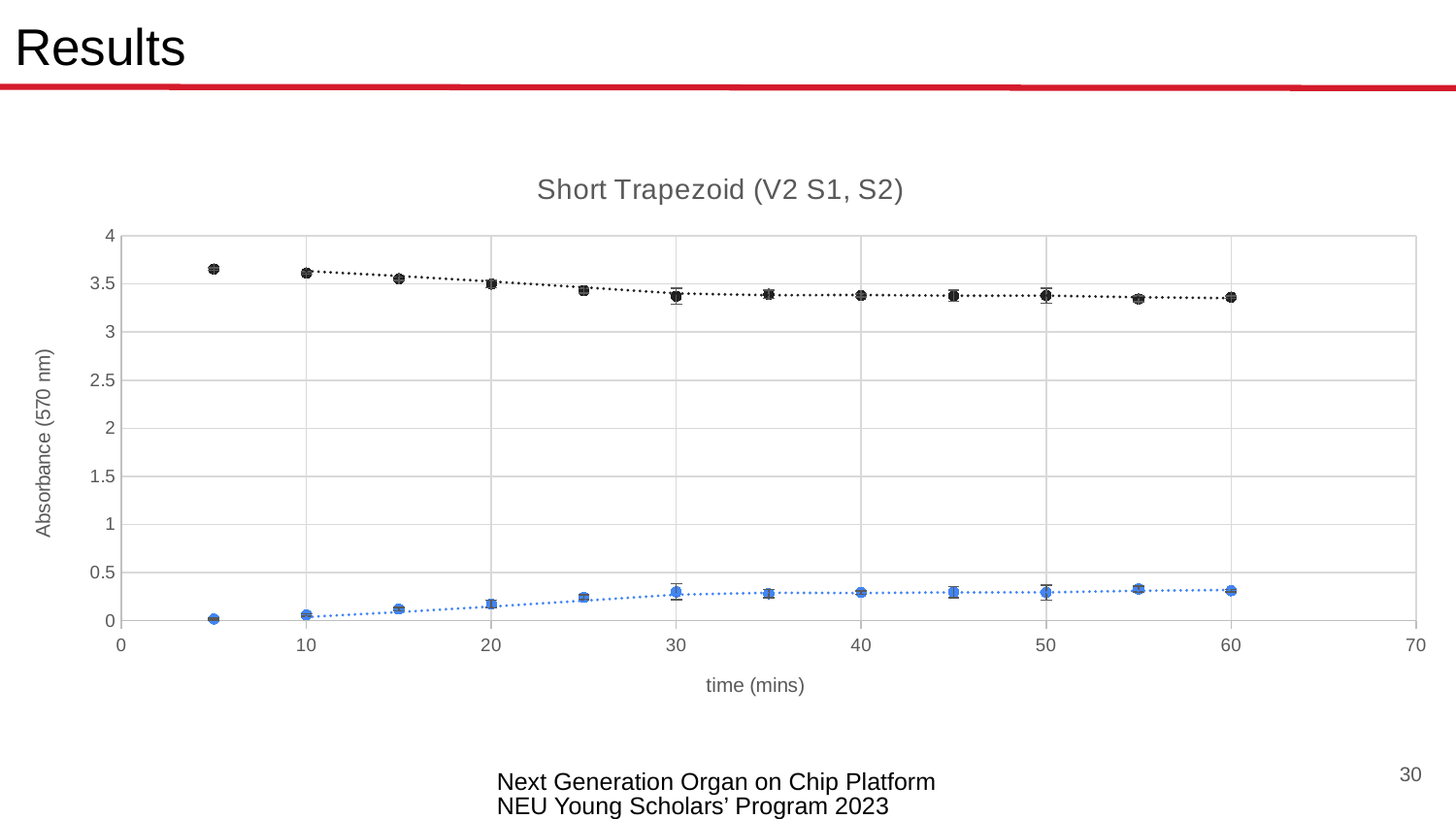
What kind of chart is shown on the slide? scatter chart What is the label of the y axis? Absorbance (570 nm) At 30 mins, which series has the larger absorbance, the black series or the blue series? the black series Is the value of the black series at 5 mins greater or less than 3.5? greater Is the value of the black series at 60 mins greater or less than 3.5? less How many data points does the black series have? 12 Is the value of the blue series at 5 mins greater or less than 0.5? less Does the blue series rise or fall as time increases? rise Does the black series rise or fall as time increases? fall What is the title of the chart? Short Trapezoid (V2 S1, S2) How many data series are plotted on the chart? 2